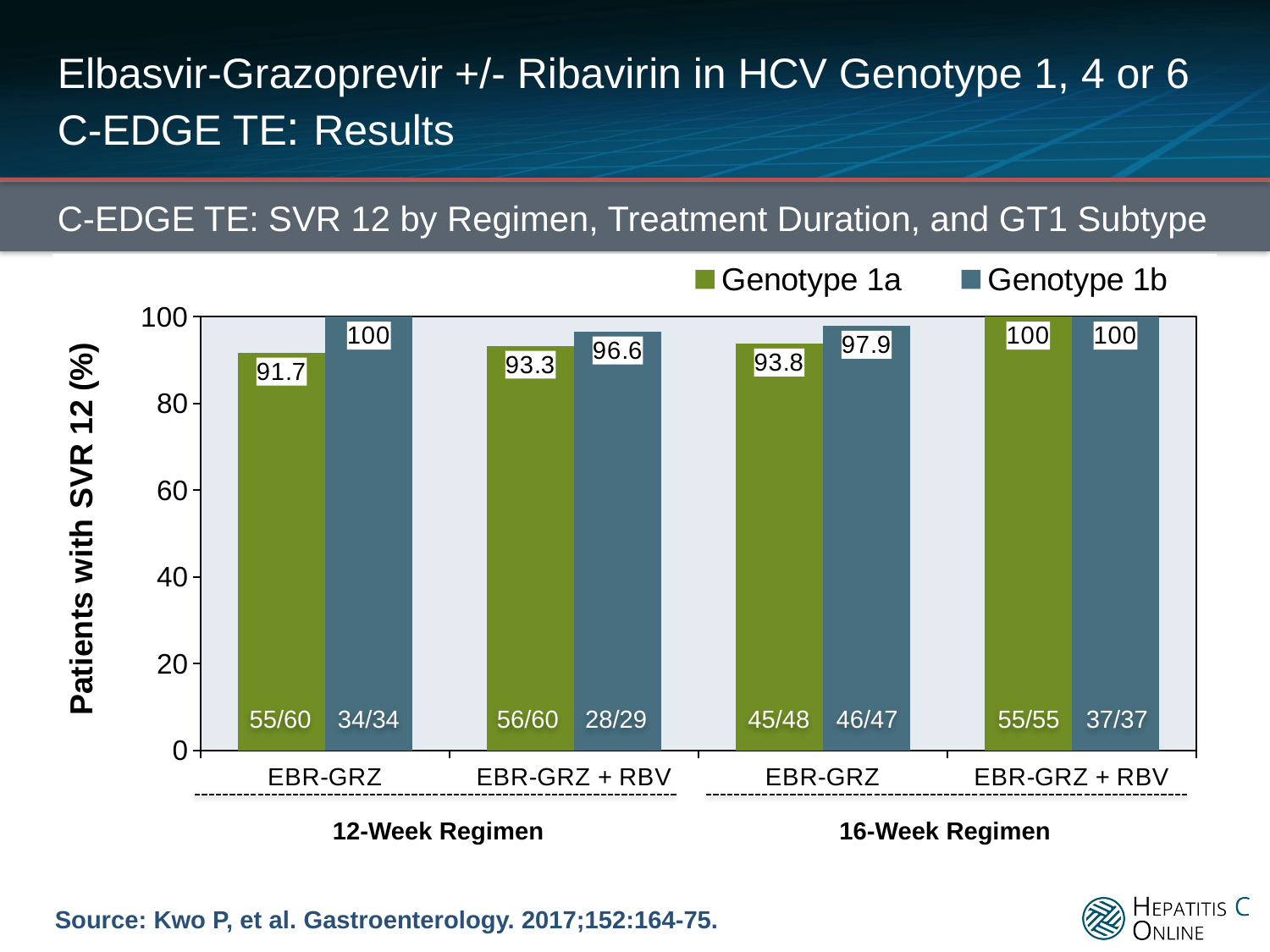
What is the label of the y axis? Patients with SVR 12 (%) What is the difference in SVR 12 rate between Genotype 1b and Genotype 1a on the 16-week EBR-GRZ regimen? 4.1 What is the SVR 12 rate for Genotype 1b patients on the 16-week EBR-GRZ regimen? 97.9 Which regimen group has the lowest SVR 12 rate for Genotype 1a? 12-Week EBR-GRZ Which is higher on the 12-week EBR-GRZ + RBV regimen: the SVR 12 rate for Genotype 1a or Genotype 1b? Genotype 1b How many regimen groups are shown along the x axis? 4 What is the SVR 12 rate for Genotype 1a patients on the 12-week EBR-GRZ regimen? 91.7 What kind of chart is shown on the slide? Bar chart What is the difference in SVR 12 rate between Genotype 1b and Genotype 1a on the 12-week EBR-GRZ regimen? 8.3 How many series does the legend list? 2 How many patients achieved SVR 12 out of the total for Genotype 1a on the 16-week EBR-GRZ regimen, as shown on the bar? 45/48 What is the SVR 12 rate for Genotype 1b patients on the 12-week EBR-GRZ + RBV regimen? 96.6